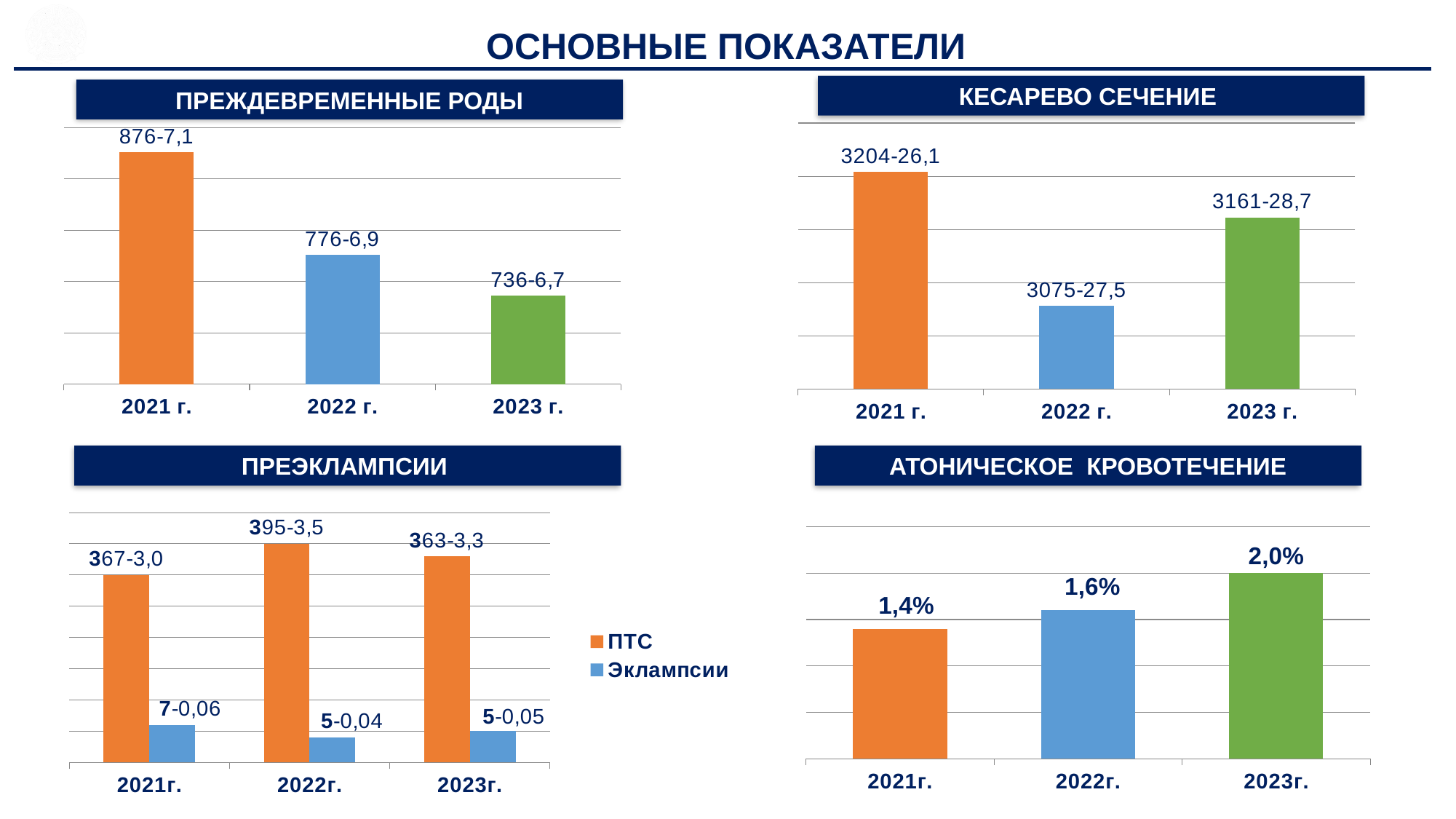
What kind of chart is the 'ПРЕЖДЕВРЕМЕННЫЕ РОДЫ' chart? bar chart In the 'АТОНИЧЕСКОЕ КРОВОТЕЧЕНИЕ' chart, do the values rise or fall from 2021г. to 2023г.? rise In the 'КЕСАРЕВО СЕЧЕНИЕ' chart, which year has the highest bar? 2021 г. In the 'ПРЕЭКЛАМПСИИ' chart, what is the data label for Эклампсии in 2021г.? 7-0,06 In the 'КЕСАРЕВО СЕЧЕНИЕ' chart, which year has the lowest bar? 2022 г. In the 'ПРЕЖДЕВРЕМЕННЫЕ РОДЫ' chart, do the values rise or fall from 2021 г. to 2023 г.? fall In the 'АТОНИЧЕСКОЕ КРОВОТЕЧЕНИЕ' chart, which is larger, the value for 2021г. or 2022г.? 2022г. In the 'КЕСАРЕВО СЕЧЕНИЕ' chart, what is the data label for 2023 г.? 3161-28,7 In the 'АТОНИЧЕСКОЕ КРОВОТЕЧЕНИЕ' chart, what is the value for 2023г.? 2,0% In the 'ПРЕЖДЕВРЕМЕННЫЕ РОДЫ' chart, what is the data label for 2021 г.? 876-7,1 How many series does the legend of the 'ПРЕЭКЛАМПСИИ' chart list? 2 In the 'ПРЕЭКЛАМПСИИ' chart, what is the data label for ПТС in 2022г.? 395-3,5